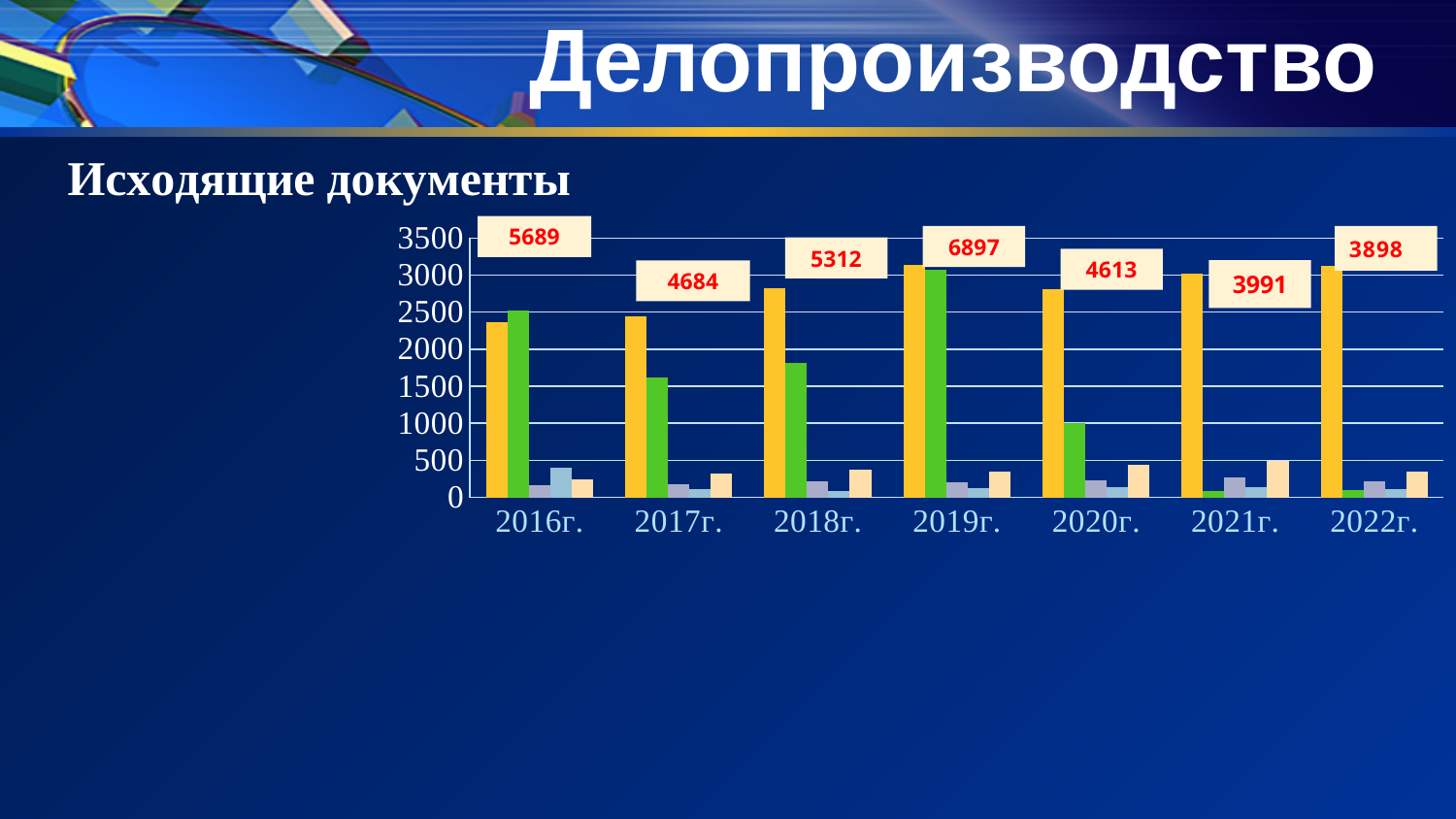
Which year has the highest labeled value? 2019г. What value is labeled above the bars for 2021г.? 3991 What kind of chart is shown on the slide? bar chart What is the difference between the labeled values for 2019г. and 2020г.? 2284 Which year has the lowest labeled value? 2022г. Which has the larger labeled value, 2018г. or 2020г.? 2018г. How many years are shown on the x axis? 7 What is the difference between the labeled values for 2016г. and 2017г.? 1005 What value is labeled above the bars for 2016г.? 5689 Is the yellow bar for 2019г. greater or less than 3000? greater What value is labeled above the bars for 2019г.? 6897 Is the green bar for 2018г. greater or less than 1500? greater